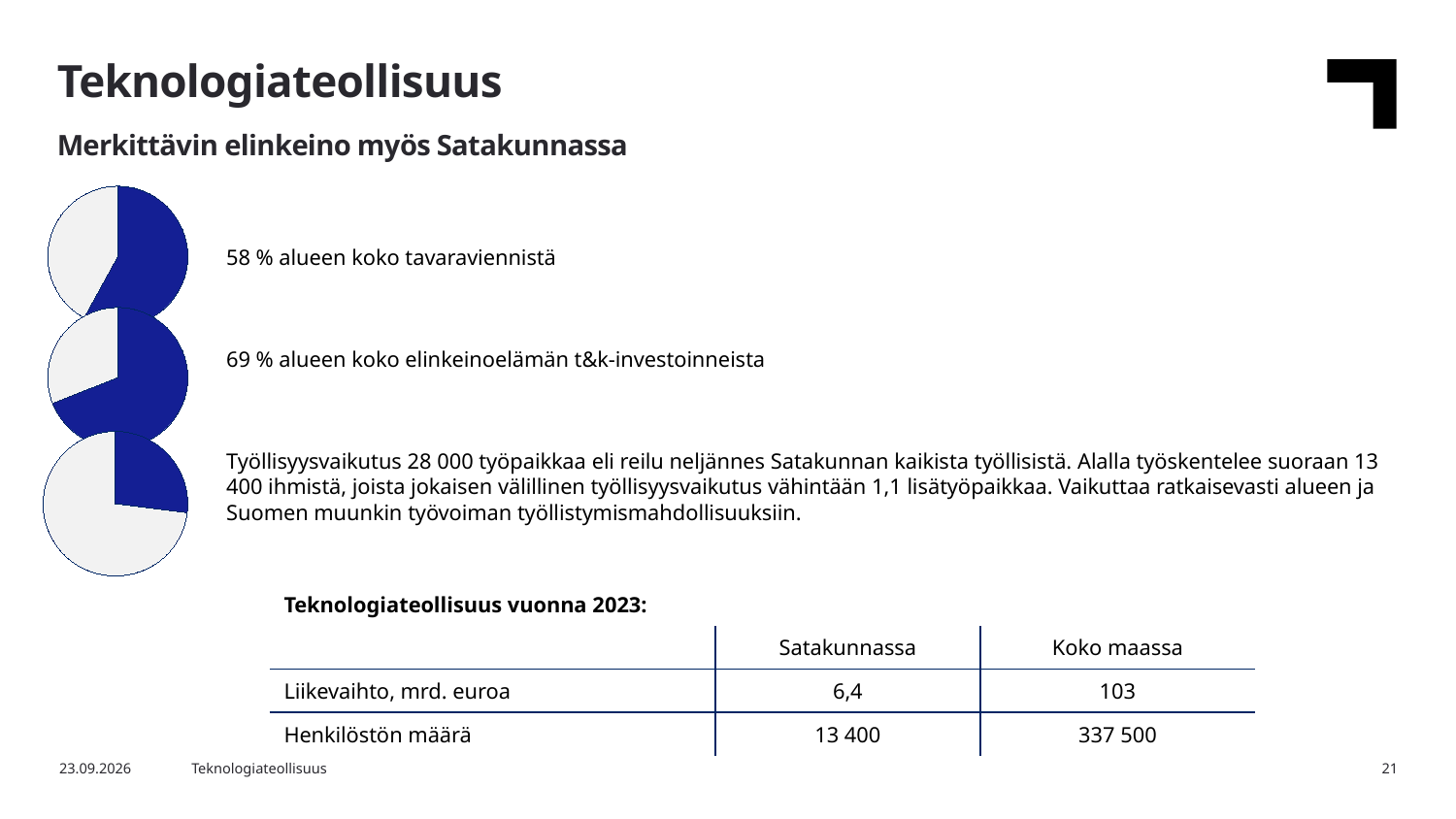
What is the difference in percentage points between the shares shown for the middle pie chart and the top pie chart? 11 percentage points Is the highlighted slice of the bottom pie chart greater or less than 50% of the pie? less Is the highlighted slice of the middle pie chart greater or less than 50% of the pie? greater What does the top pie chart represent, according to the text beside it? 58 % alueen koko tavaraviennistä What colour is the highlighted slice in each pie chart? Blue How many pie charts are shown on the slide? 3 What share does the highlighted slice of the top pie chart represent, according to the text next to it? 58 % Which of the three pie charts has the largest highlighted slice? The middle one Which pie chart has the larger highlighted slice, the top one or the middle one? The middle one Which of the three pie charts has the smallest highlighted slice? The bottom one What kind of chart is used on the left side of the slide? Pie chart What share does the highlighted slice of the middle pie chart represent, according to the text next to it? 69 %